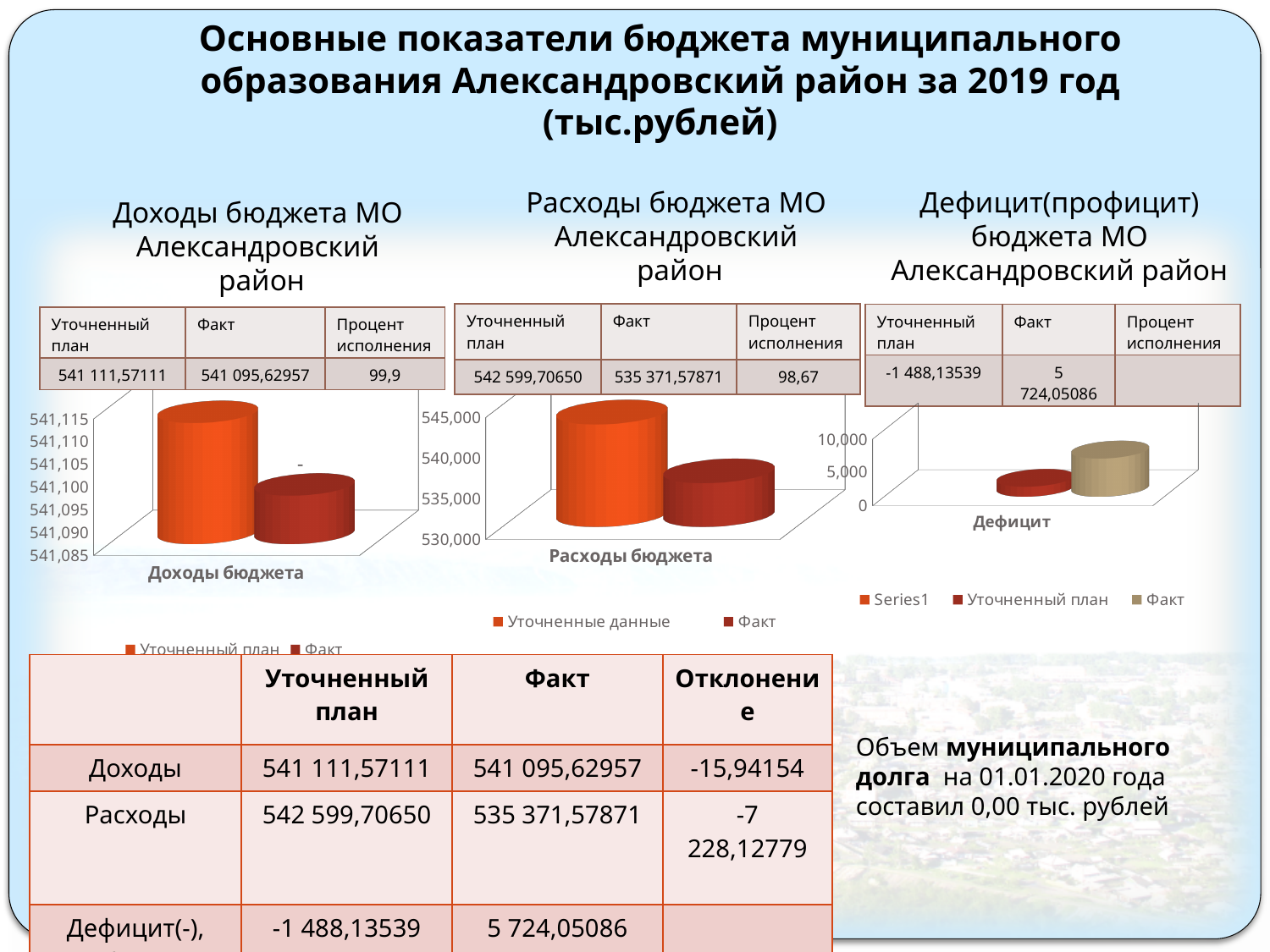
In the 'Дефицит(профицит) бюджета МО Александровский район' chart, which bar is taller, Уточненный план or Факт? Факт What kind of chart is the 'Доходы бюджета МО Александровский район' chart? bar chart In the 'Расходы бюджета МО Александровский район' chart, what is the category label shown on the x axis? Расходы бюджета In the 'Дефицит(профицит) бюджета МО Александровский район' chart, is the value for Факт greater or less than 5,000? greater In the 'Расходы бюджета МО Александровский район' chart, which is larger, Уточненные данные or Факт? Уточненные данные In the 'Доходы бюджета МО Александровский район' chart, is the value for Уточненный план greater or less than 541,105? greater In the 'Расходы бюджета МО Александровский район' chart, is the value for Уточненные данные greater or less than 540,000? greater In the 'Дефицит(профицит) бюджета МО Александровский район' chart, how many entries does the legend list? 3 In the 'Доходы бюджета МО Александровский район' chart, which is larger, Уточненный план or Факт? Уточненный план In the 'Доходы бюджета МО Александровский район' chart, how many series does the legend list? 2